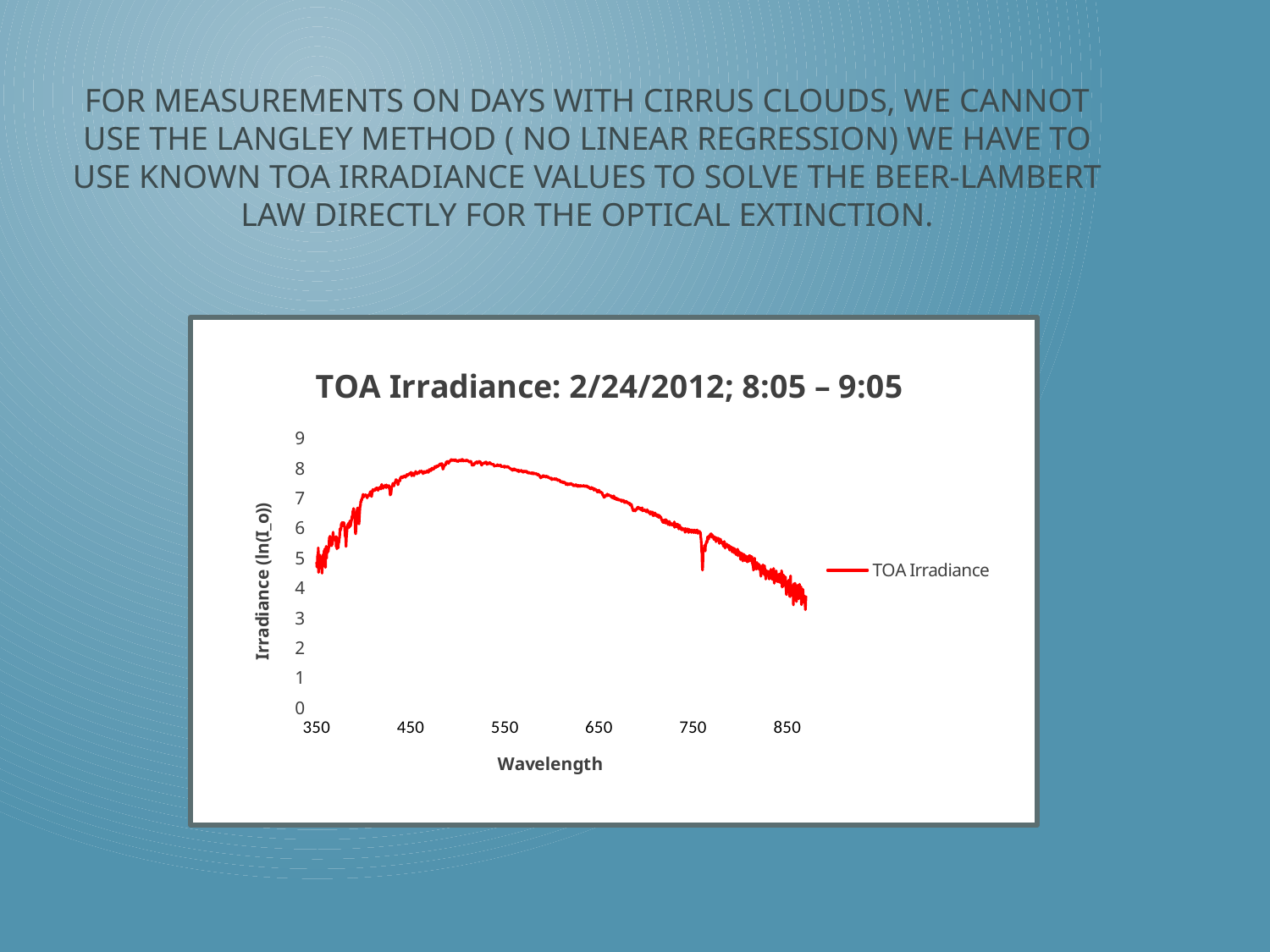
How many series does the legend list? 1 Does the TOA Irradiance line rise or fall between wavelengths 550 and 850? fall What is the title of the chart? TOA Irradiance: 2/24/2012; 8:05 – 9:05 Is the TOA Irradiance value at wavelength 850 greater or less than 5? less Which is larger, the TOA Irradiance value at wavelength 450 or at wavelength 850? 450 Is the TOA Irradiance value at wavelength 650 greater or less than 6? greater Does the TOA Irradiance line rise or fall between wavelengths 350 and 450? rise Is the TOA Irradiance value at wavelength 550 greater or less than 7? greater What is the label of the x axis? Wavelength How many tick labels are shown on the x axis? 6 What kind of chart is shown on the slide? line chart